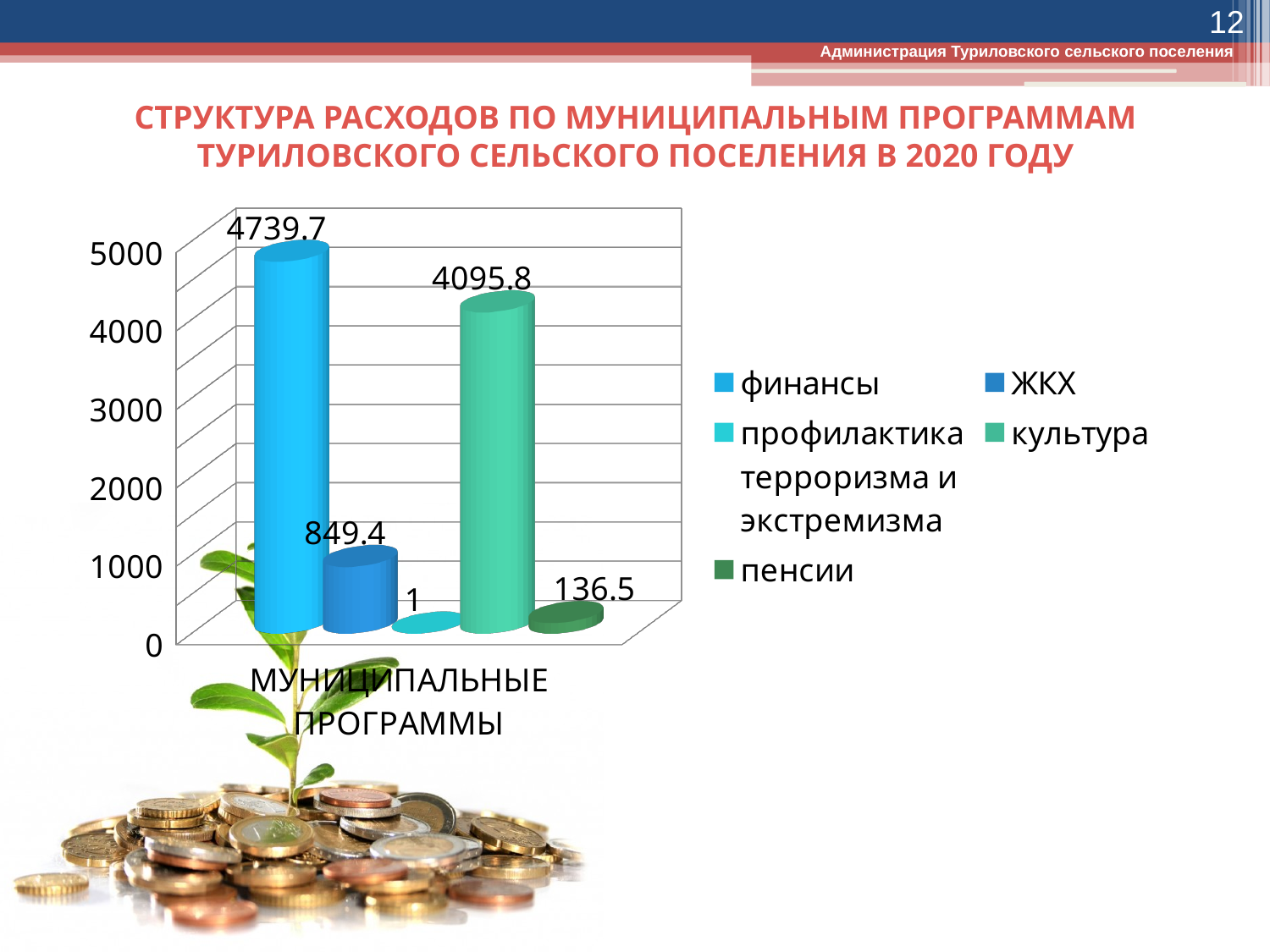
What is the value for пенсии? 136.5 What kind of chart is shown on the slide? bar chart What is the value for профилактика терроризма и экстремизма? 1 Which is larger, the value for ЖКХ or the value for пенсии? ЖКХ What is the category label shown on the x axis? МУНИЦИПАЛЬНЫЕ ПРОГРАММЫ How many series does the legend list? 5 Which series has the lowest value? профилактика терроризма и экстремизма What is the difference between the values for финансы and культура? 643.9 What is the value for ЖКХ? 849.4 What is the value for культура? 4095.8 Which series has the highest value? финансы What is the value for финансы? 4739.7